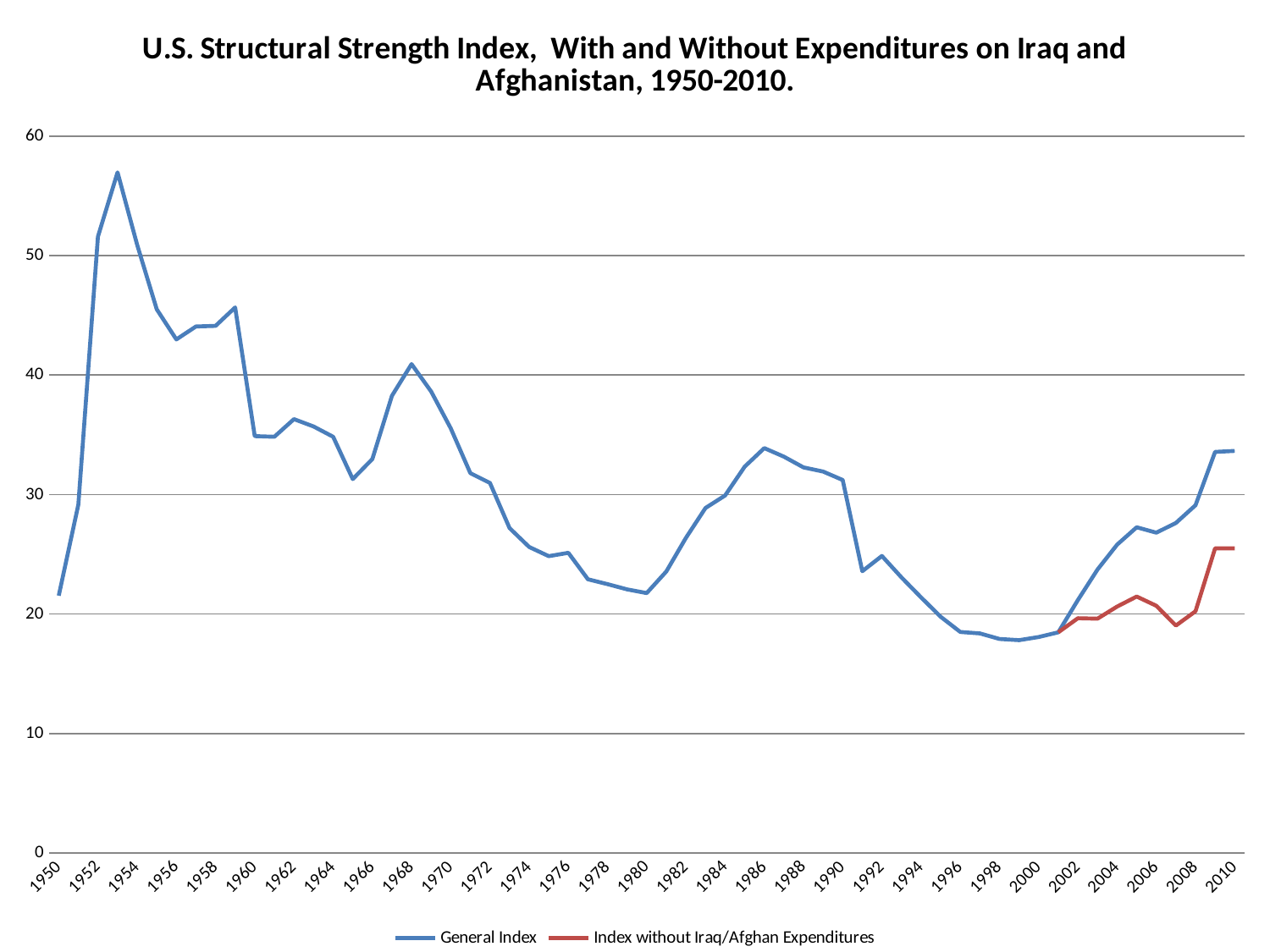
Which series is drawn in red? Index without Iraq/Afghan Expenditures Does the General Index rise or fall between 2000 and 2010? rise Is the General Index value for 1953 greater or less than 50? greater What kind of chart is shown on the slide? Line chart What is the title of the chart? U.S. Structural Strength Index, With and Without Expenditures on Iraq and Afghanistan, 1950-2010. Is the General Index value for 1996 greater or less than 20? less In 2010, which series has the higher value, the General Index or the Index without Iraq/Afghan Expenditures? General Index In which year does the General Index reach its highest value? 1953 How many series does the legend list? 2 Is the General Index value for 2010 greater or less than 30? greater